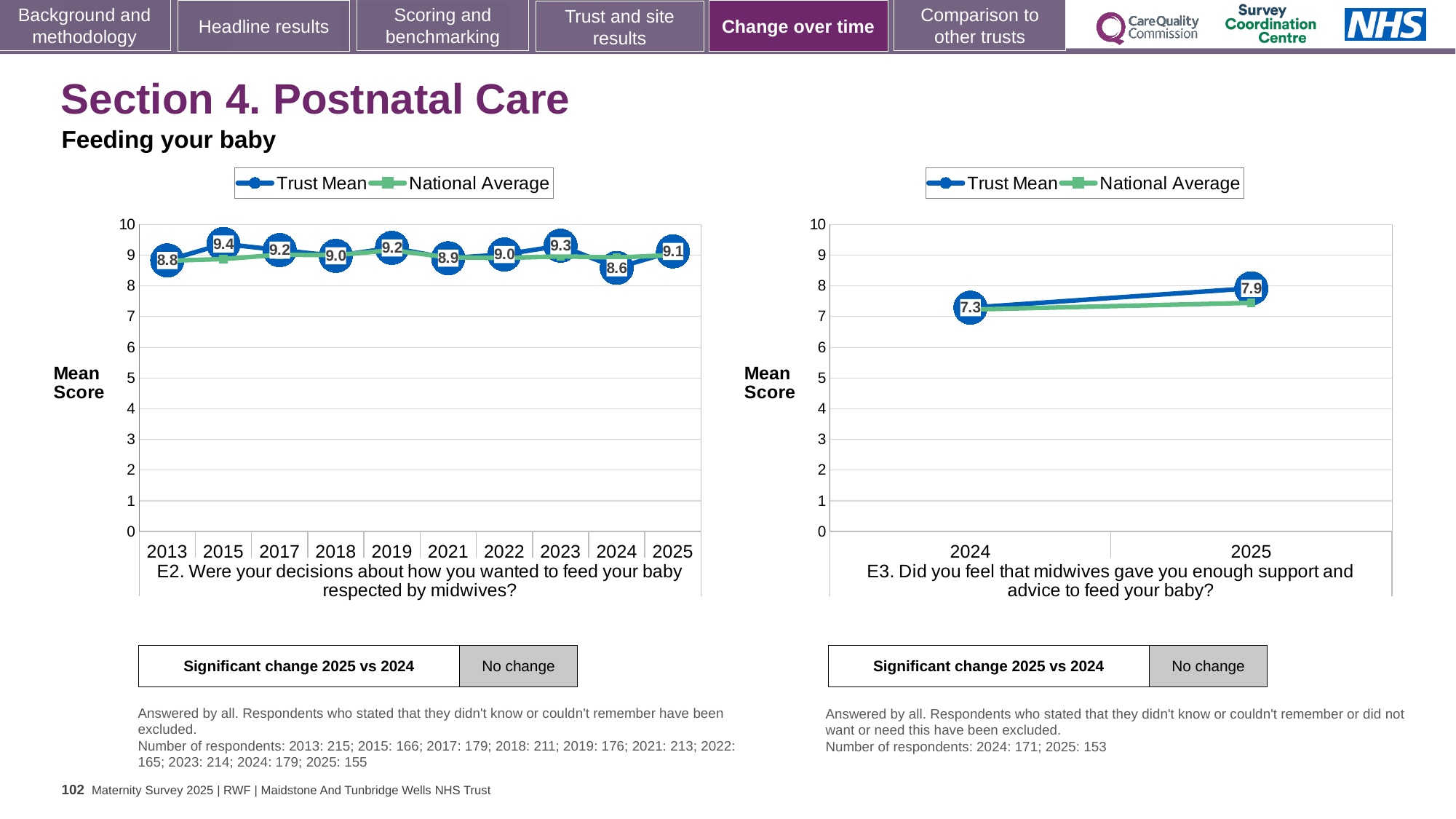
How many series does the legend of the E3 chart (right) list? 2 In the E2 chart (left), how many years are shown on the x axis? 10 In the E3 chart (right), what is the Trust Mean for 2024? 7.3 In the E3 chart (right), what is the Trust Mean for 2025? 7.9 In the E3 chart (right), does the Trust Mean rise or fall from 2024 to 2025? rise What kind of chart is the E2 chart (left)? line chart In the E2 chart (left), which year has the highest Trust Mean? 2015 In the E2 chart (left), what is the Trust Mean for 2025? 9.1 In the E2 chart (left), which year has the lowest Trust Mean? 2024 In the E3 chart (right), is the National Average for 2025 greater or less than 8? less In the E2 chart (left), what is the Trust Mean for 2024? 8.6 In the E2 chart (left), what is the difference between the Trust Mean for 2025 and 2024? 0.5